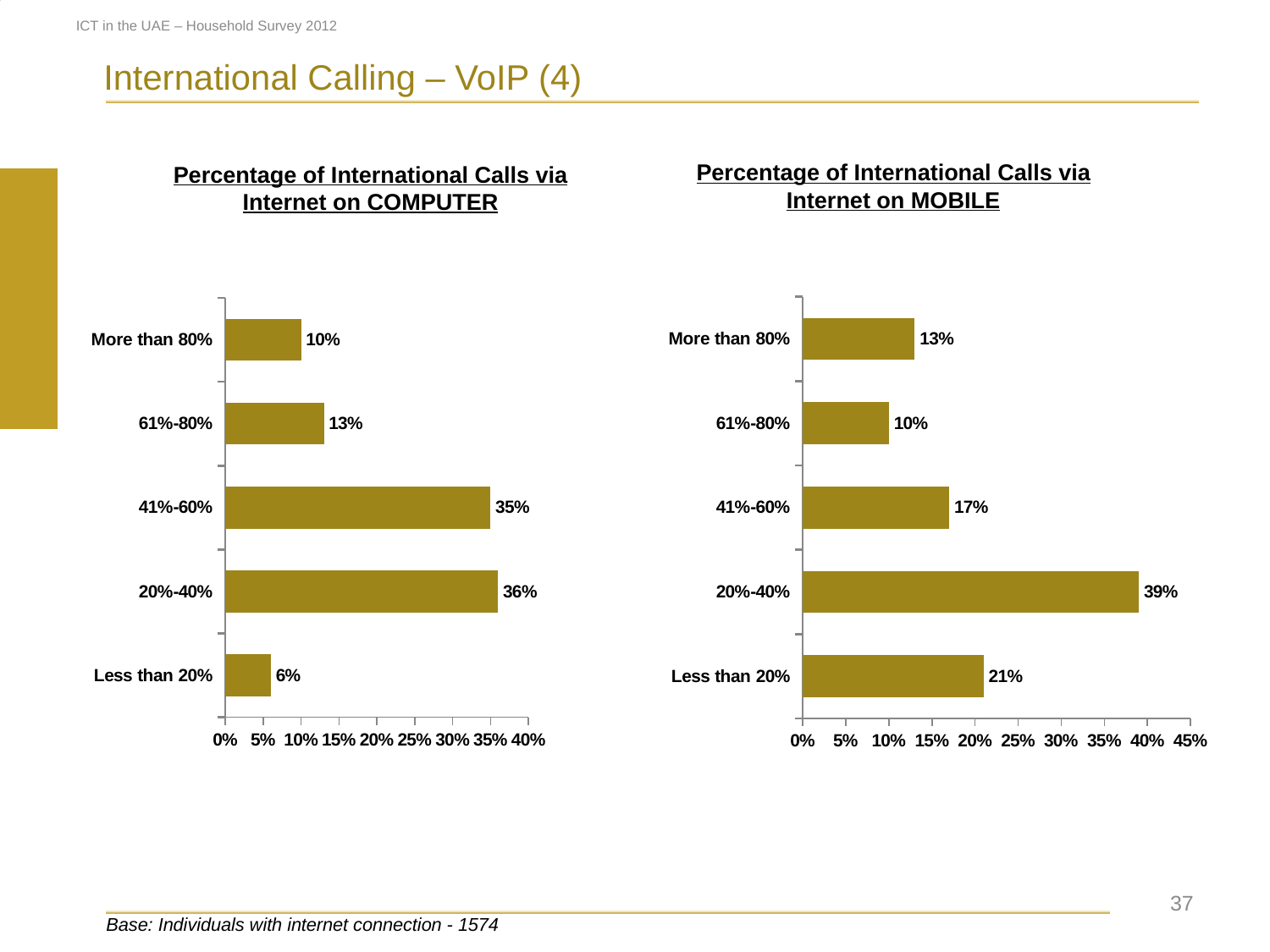
In the 'Percentage of International Calls via Internet on COMPUTER' chart, how many categories are shown? 5 In the 'Percentage of International Calls via Internet on COMPUTER' chart, what is the value for '61%-80%'? 13% In the 'Percentage of International Calls via Internet on COMPUTER' chart, what is the difference between the values for '41%-60%' and 'More than 80%'? 25% In the 'Percentage of International Calls via Internet on COMPUTER' chart, what is the value for '20%-40%'? 36% What type of chart is the 'Percentage of International Calls via Internet on MOBILE' chart? Bar chart In the 'Percentage of International Calls via Internet on MOBILE' chart, what is the value for 'Less than 20%'? 21% In the 'Percentage of International Calls via Internet on MOBILE' chart, which category has the lowest value? 61%-80% In the 'Percentage of International Calls via Internet on COMPUTER' chart, which category has the lowest value? Less than 20% In the 'Percentage of International Calls via Internet on MOBILE' chart, which is larger: the value for '41%-60%' or the value for 'More than 80%'? 41%-60% In the 'Percentage of International Calls via Internet on MOBILE' chart, what is the difference between the values for '20%-40%' and 'Less than 20%'? 18% In the 'Percentage of International Calls via Internet on MOBILE' chart, which category has the highest value? 20%-40% What is the highest tick value shown on the x axis of the 'Percentage of International Calls via Internet on MOBILE' chart? 45%